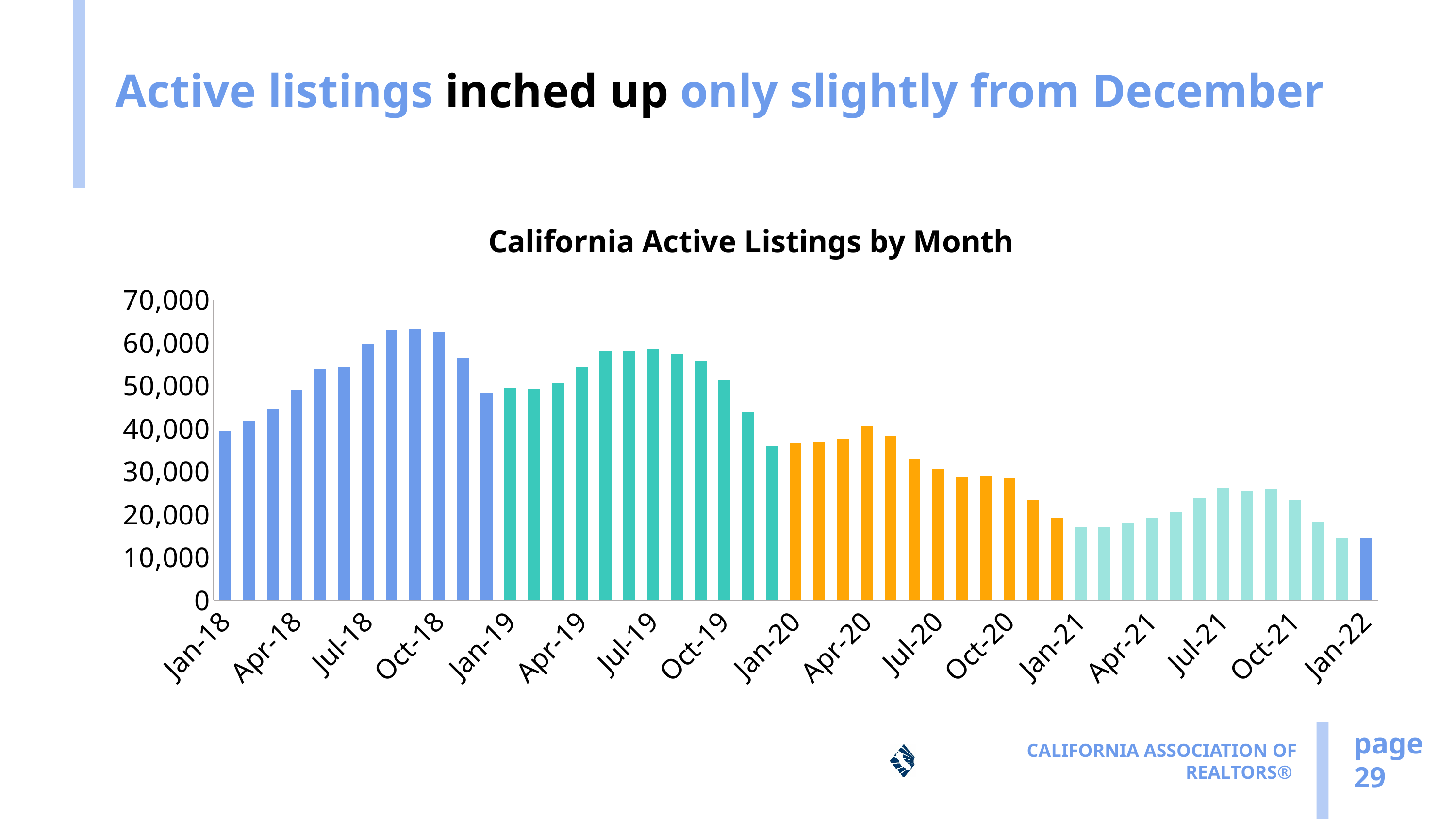
Is the value for Oct-18 greater or less than 60,000? greater Is the value for Jan-22 greater or less than 20,000? less Which is larger, the value for Oct-18 or the value for Oct-21? Oct-18 What is the title of the chart? California Active Listings by Month Do the values generally rise or fall from Jan-20 to Jan-21? fall What kind of chart is shown on the slide? bar chart Is the value for Jan-21 greater or less than 20,000? less What is the highest value shown on the vertical axis? 70,000 Which is larger, the value for Jul-19 or the value for Jul-20? Jul-19